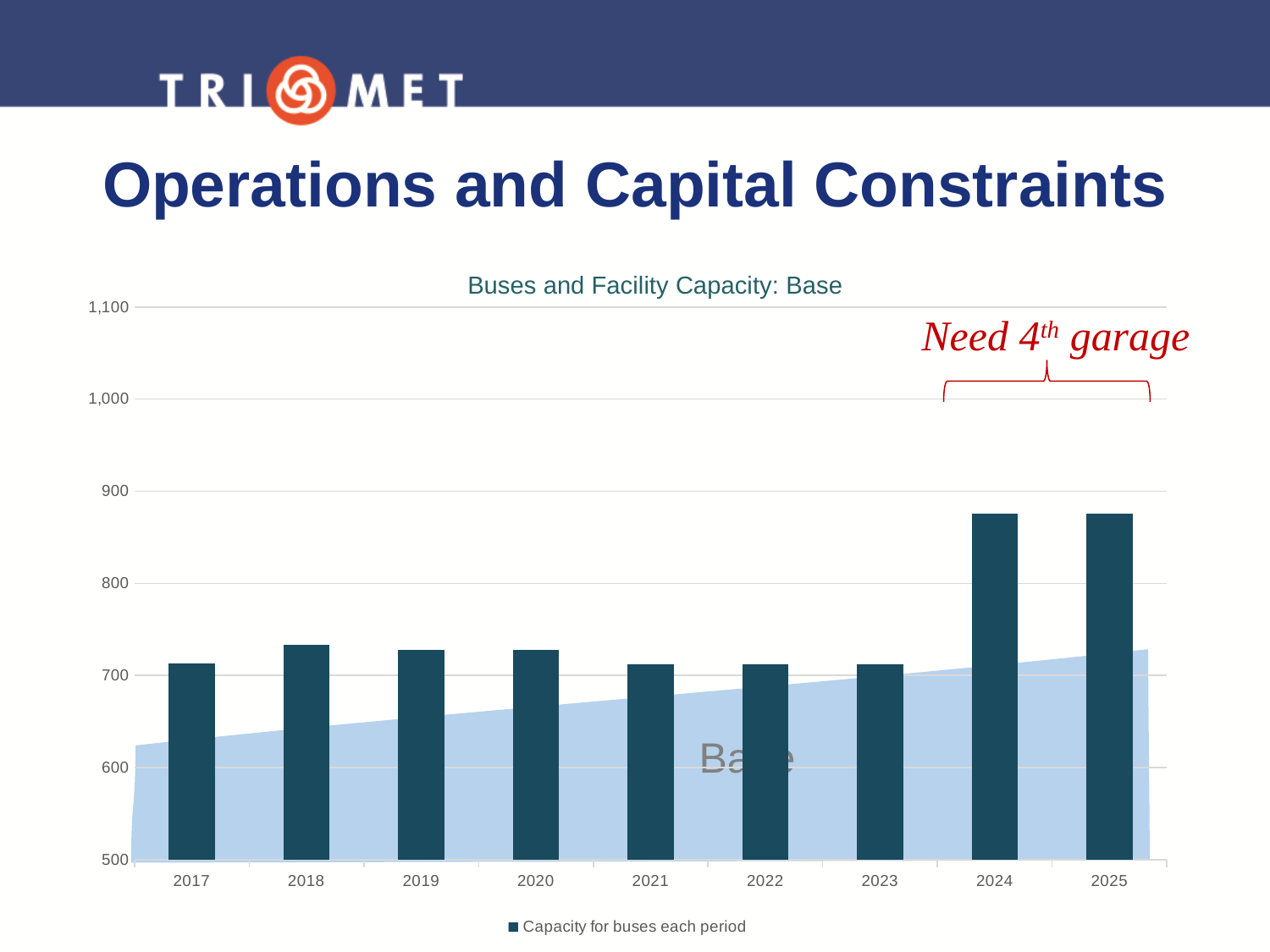
How many series does the legend list? 1 Is the value for 2018 greater or less than 800? less Do the bar values rise or fall from 2023 to 2024? rise What is the title of the chart? Buses and Facility Capacity: Base Is the value for 2024 greater or less than 900? less Is the value for 2024 greater or less than 800? greater Which is larger, the value for 2018 or the value for 2021? 2018 What is the legend entry for the bars? Capacity for buses each period Which is larger, the value for 2023 or the value for 2024? 2024 How many years are shown on the x axis of the chart? 9 What kind of chart is shown on the slide? bar chart